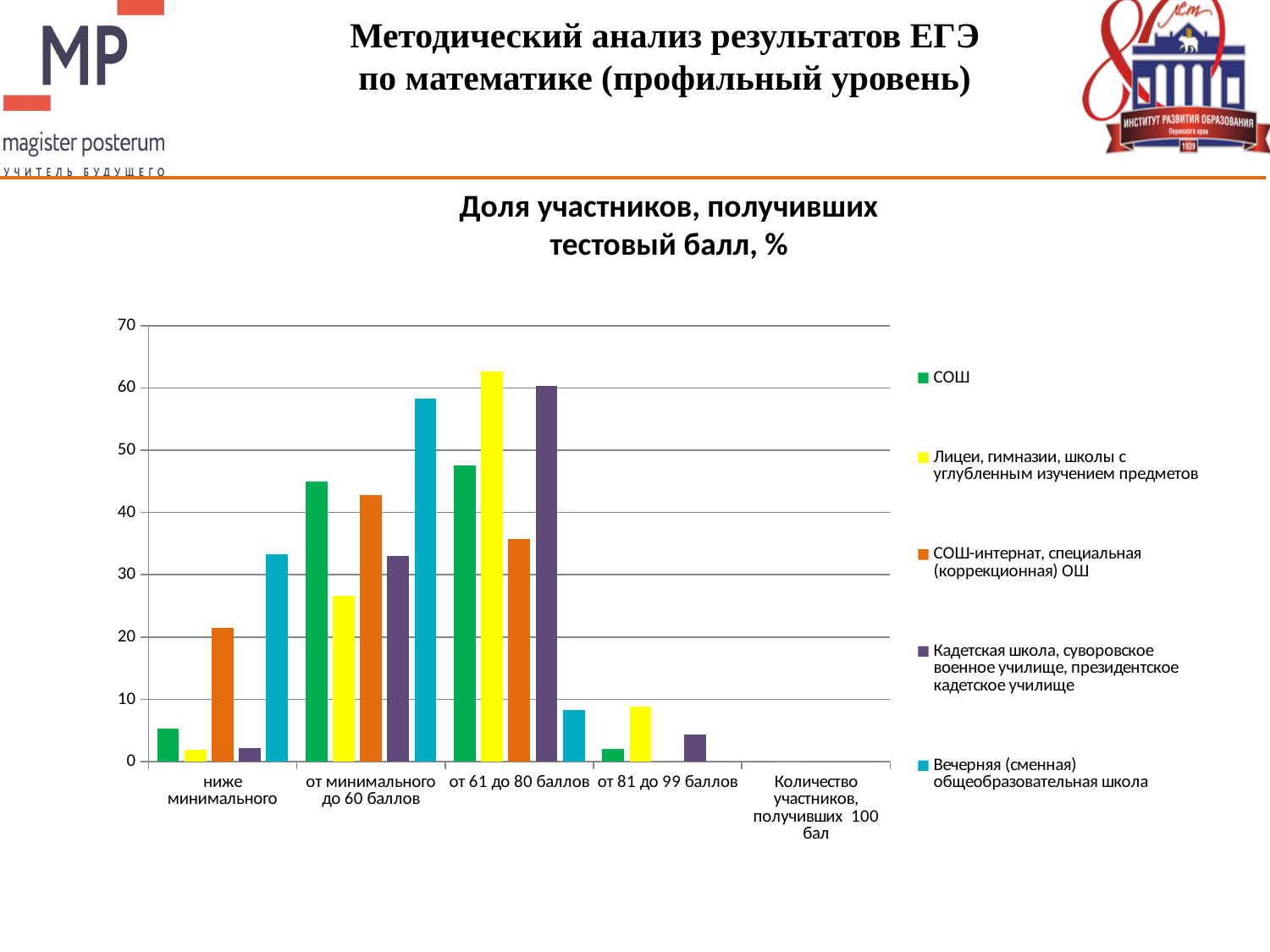
In the category 'от 61 до 80 баллов', which is larger: the value for СОШ or the value for СОШ-интернат, специальная (коррекционная) ОШ? СОШ Is the value for СОШ in the category 'от минимального до 60 баллов' greater or less than 40? greater Is the value for СОШ-интернат, специальная (коррекционная) ОШ in the category 'ниже минимального' greater or less than 30? less In the category 'ниже минимального', which series has the highest value? Вечерняя (сменная) общеобразовательная школа What is the title of the chart? Доля участников, получивших тестовый балл, % What kind of chart is shown on the slide? bar chart How many categories are shown along the x axis? 5 Is the value for Лицеи, гимназии, школы с углубленным изучением предметов in the category 'от 61 до 80 баллов' greater or less than 60? greater How many series does the legend list? 5 In the category 'от минимального до 60 баллов', which series has the lowest value? Лицеи, гимназии, школы с углубленным изучением предметов In the category 'от минимального до 60 баллов', which series has the highest value? Вечерняя (сменная) общеобразовательная школа